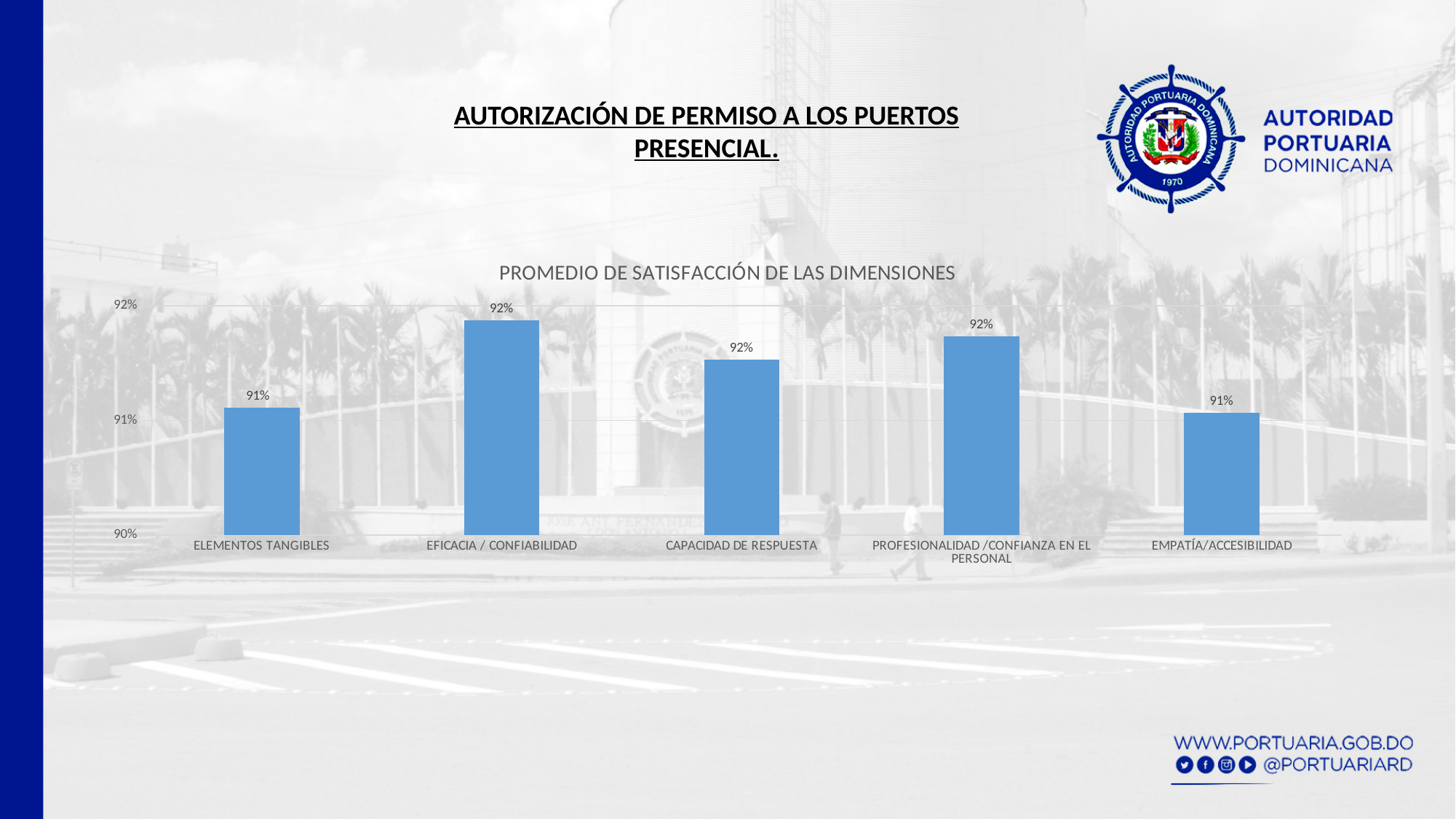
Which category has the tallest bar in the chart? EFICACIA / CONFIABILIDAD What is the value for ELEMENTOS TANGIBLES? 91% What is the value for CAPACIDAD DE RESPUESTA? 92% Is the value for EMPATÍA/ACCESIBILIDAD greater or less than 92%? less What kind of chart is shown on the slide? bar chart What is the title of the chart? PROMEDIO DE SATISFACCIÓN DE LAS DIMENSIONES How many categories are plotted in the chart? 5 What is the value for PROFESIONALIDAD /CONFIANZA EN EL PERSONAL? 92% What is the value for EFICACIA / CONFIABILIDAD? 92% What is the value for EMPATÍA/ACCESIBILIDAD? 91% Is the value for CAPACIDAD DE RESPUESTA greater or less than 91%? greater